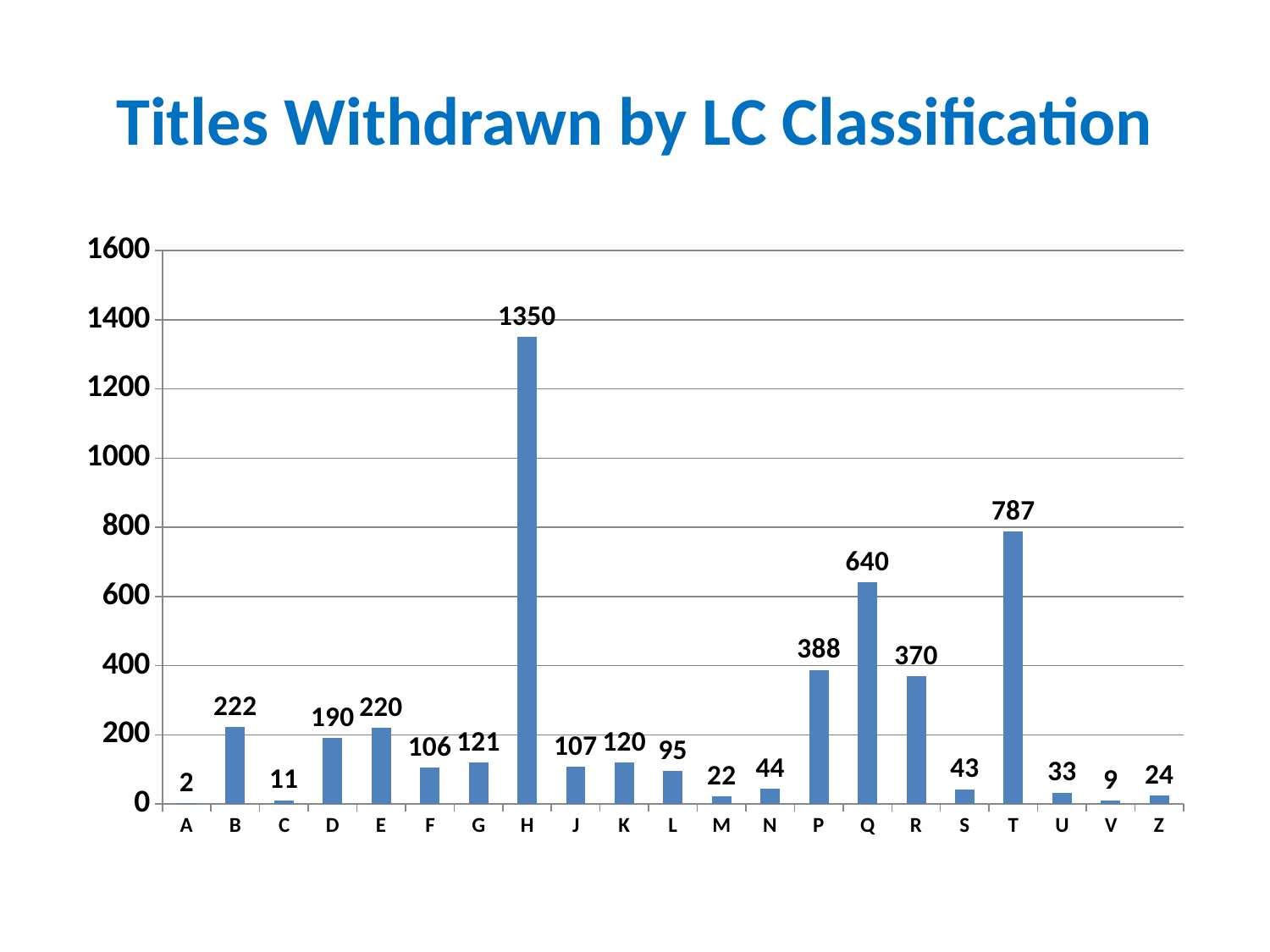
Which classification has the highest number of titles withdrawn? H How many classification categories are shown on the x axis? 21 Is the value for T greater or less than 600? greater What is the value for classification Q? 640 Which is larger, the value for P or the value for R? P What is the difference between the values for T and Q? 147 What is the title of the chart? Titles Withdrawn by LC Classification What is the value for classification H? 1350 What kind of chart is shown on the slide? bar chart What is the difference between the values for B and E? 2 What is the value for classification L? 95 Which classification has the lowest number of titles withdrawn? A